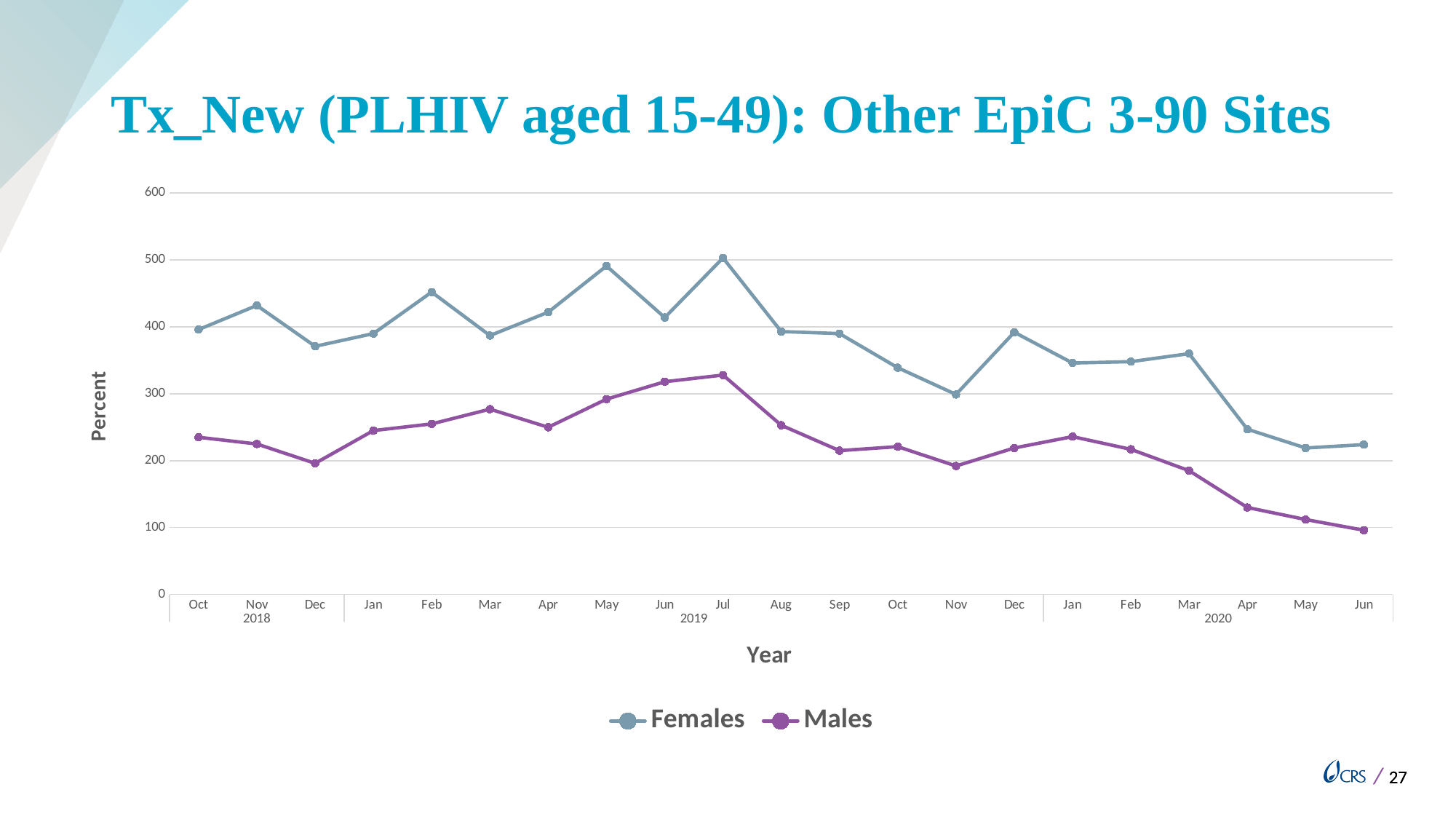
Is the value for Males in Jul 2019 greater or less than 300? greater Which is higher for Females: Feb 2019 or Mar 2019? Feb 2019 What is the label on the vertical axis? Percent How many series does the legend list? 2 In which month does the Females series reach its highest value? Jul 2019 What kind of chart is shown on the slide? Line chart Is the value for Males in Apr 2020 greater or less than 100? greater In which month does the Males series reach its lowest value? Jun 2020 How many monthly data points are plotted for each series? 21 In which month does the Males series reach its highest value? Jul 2019 Do the Males values rise or fall from Jan 2020 to Jun 2020? Fall